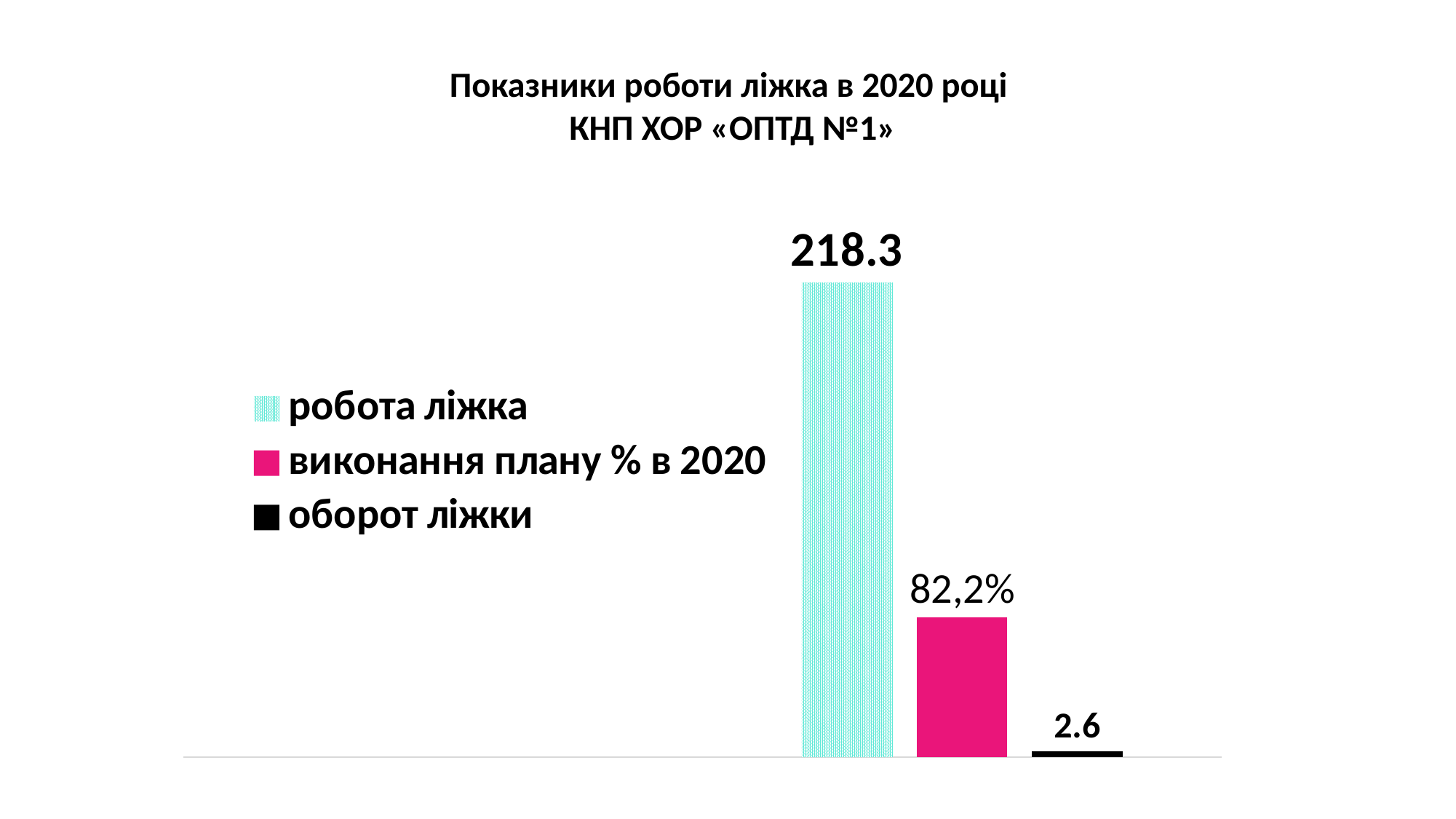
What is the difference between the value for робота ліжка and the value for оборот ліжки? 215.7 How many series does the legend list? 3 Which is larger, the value for робота ліжка or the value for виконання плану % в 2020? робота ліжка Which series has the highest value? робота ліжка What kind of chart is shown on the slide? bar chart How many bars are plotted on the chart? 3 What is the value for виконання плану % в 2020? 82,2% Which series has the lowest value? оборот ліжки What colour is the bar for виконання плану % в 2020? pink What is the value for робота ліжка? 218.3 What is the value for оборот ліжки? 2.6 What is the title of the chart? Показники роботи ліжка в 2020 році КНП ХОР «ОПТД №1»